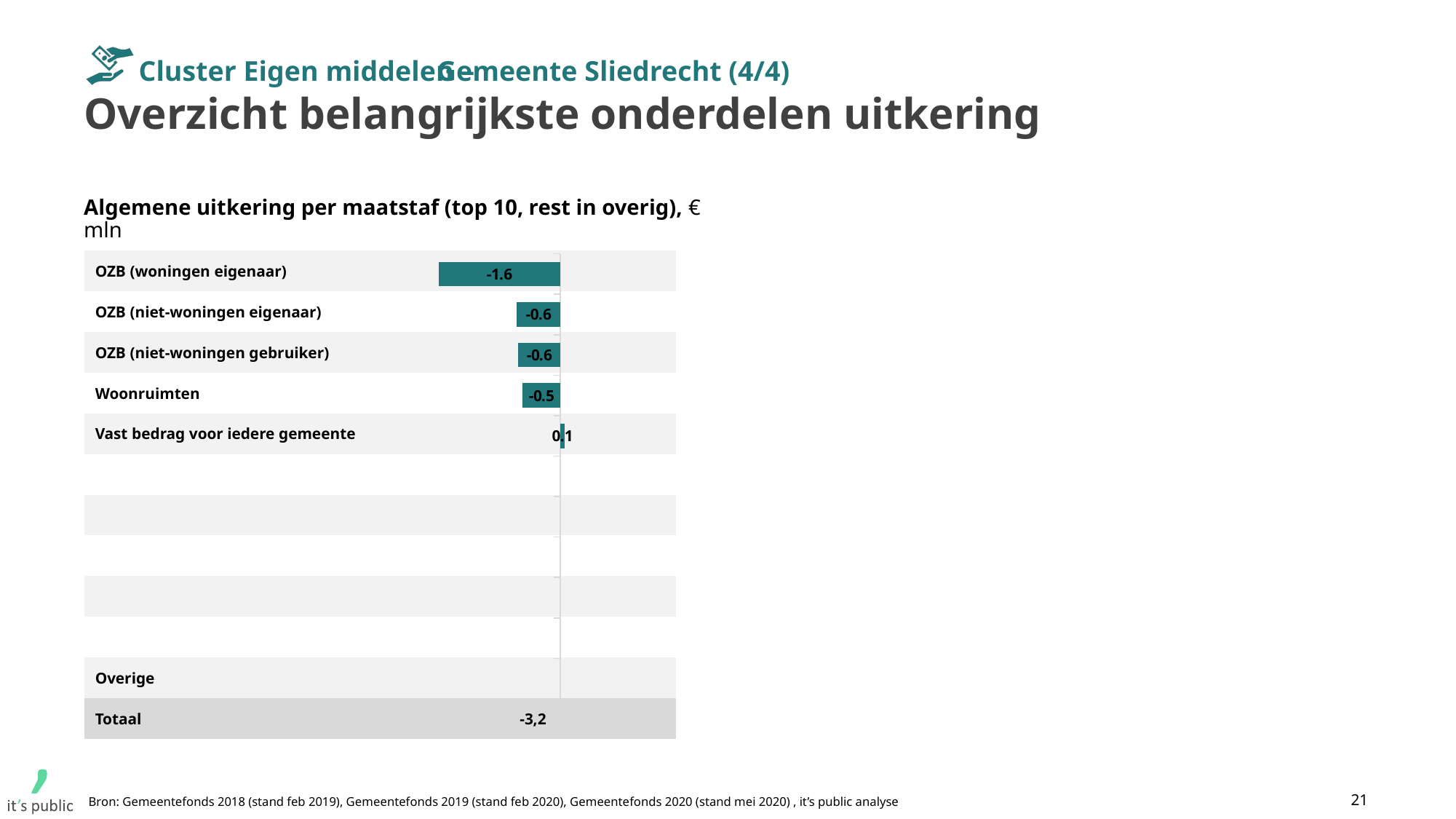
What is the value for OZB (woningen eigenaar)? -1.6 Which category has the highest value? Vast bedrag voor iedere gemeente By how much is the value for OZB (woningen eigenaar) lower than the value for Woonruimten? 1.1 What is the value for OZB (niet-woningen gebruiker)? -0.6 In what unit are the chart values expressed, according to the chart title? € mln What is the value shown for Totaal? -3,2 How many categories have a plotted bar with a data label? 5 What is the value for Woonruimten? -0.5 What kind of chart is shown on the slide? Bar chart What is the value for Vast bedrag voor iedere gemeente? 0.1 Which has the larger (less negative) value: OZB (woningen eigenaar) or Woonruimten? Woonruimten Which category has the lowest (most negative) value? OZB (woningen eigenaar)